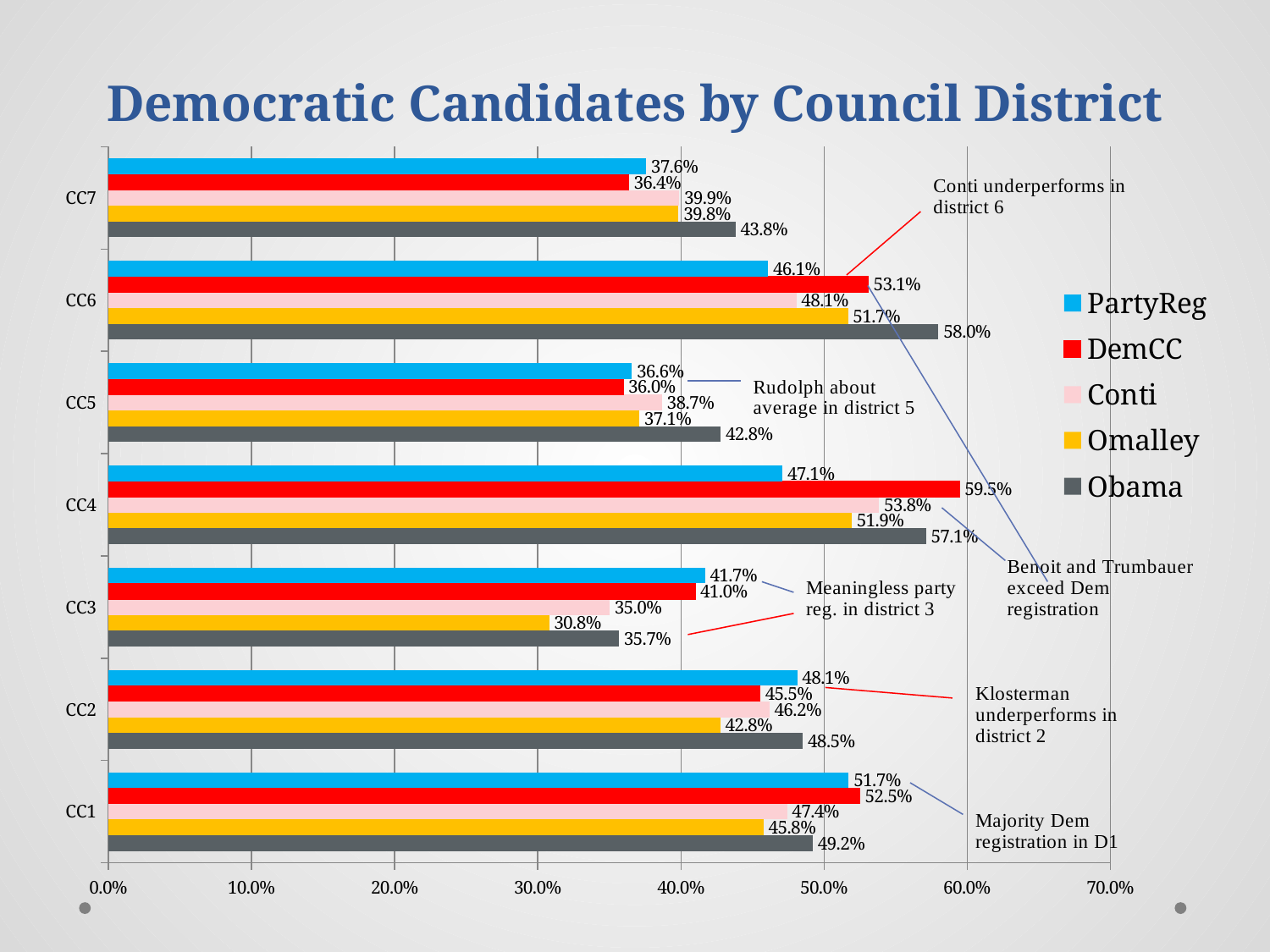
Which council district has the highest DemCC value? CC4 For CC3, which is larger: the PartyReg value or the Omalley value? PartyReg What is the DemCC value for CC4? 59.5% What is the title of the chart? Democratic Candidates by Council District What is the Obama value for CC6? 58.0% How many council districts are shown on the chart? 7 What kind of chart is shown on the slide? Bar chart How many series does the legend list? 5 What is the difference between the Obama and PartyReg values for CC6? 11.9% What is the difference between the DemCC and PartyReg values for CC1? 0.8% Which council district has the lowest Omalley value? CC3 What is the Conti value for CC7? 39.9%